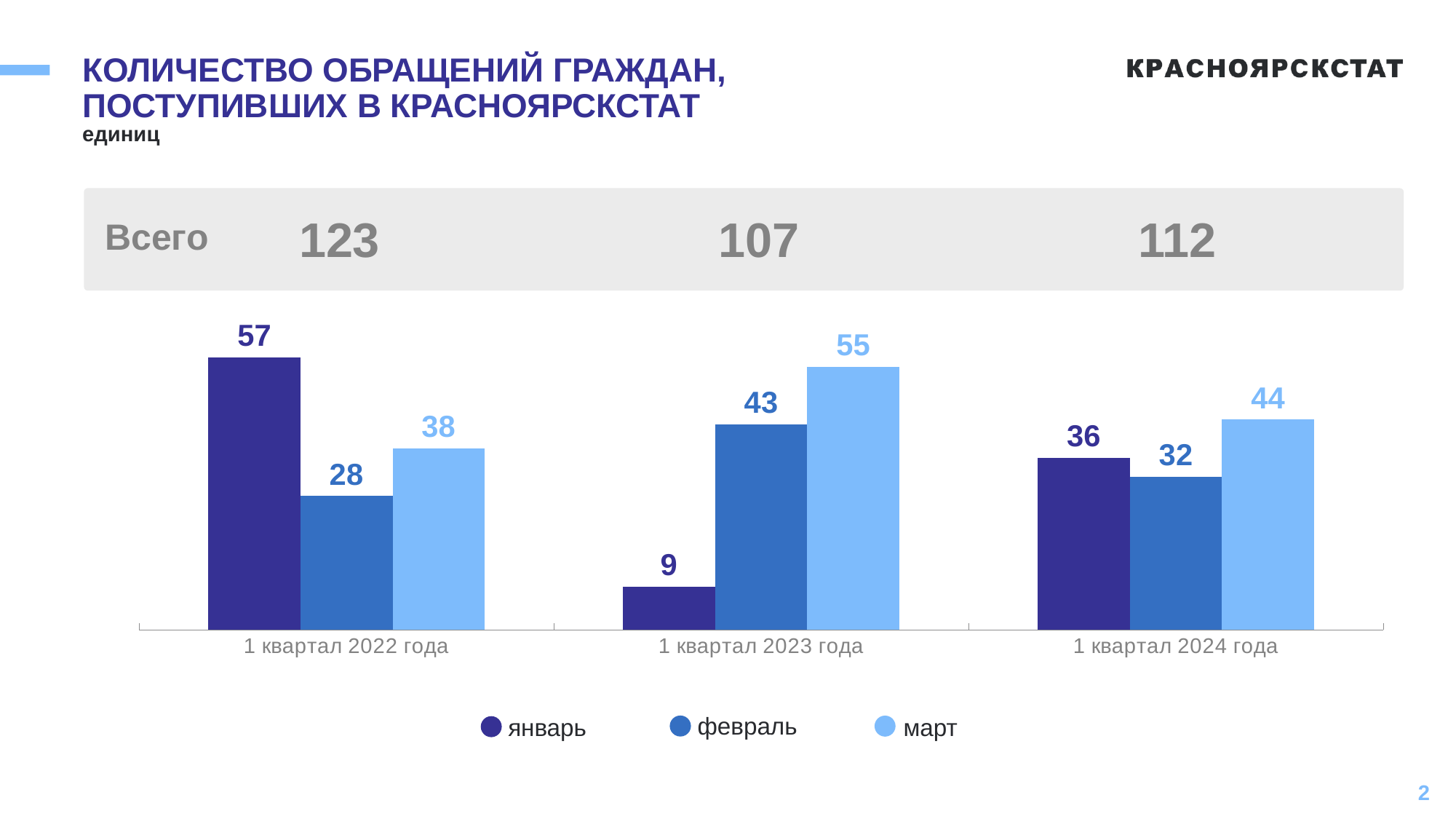
What is the value for январь in 1 квартал 2022 года? 57 How many series does the legend list? 3 What kind of chart is shown on the slide? bar chart Which month has the highest value in 1 квартал 2022 года? январь Which month has the lowest value in 1 квартал 2023 года? январь What is the value for февраль in 1 квартал 2024 года? 32 What is the difference between the март and февраль values in 1 квартал 2022 года? 10 What is the total (Всего) shown for 1 квартал 2023 года? 107 Do the январь values rise or fall from 1 квартал 2022 года to 1 квартал 2023 года? fall What is the value for март in 1 квартал 2023 года? 55 How many quarters (categories) are shown on the x axis? 3 Which is larger: январь in 1 квартал 2024 года or февраль in 1 квартал 2024 года? январь in 1 квартал 2024 года